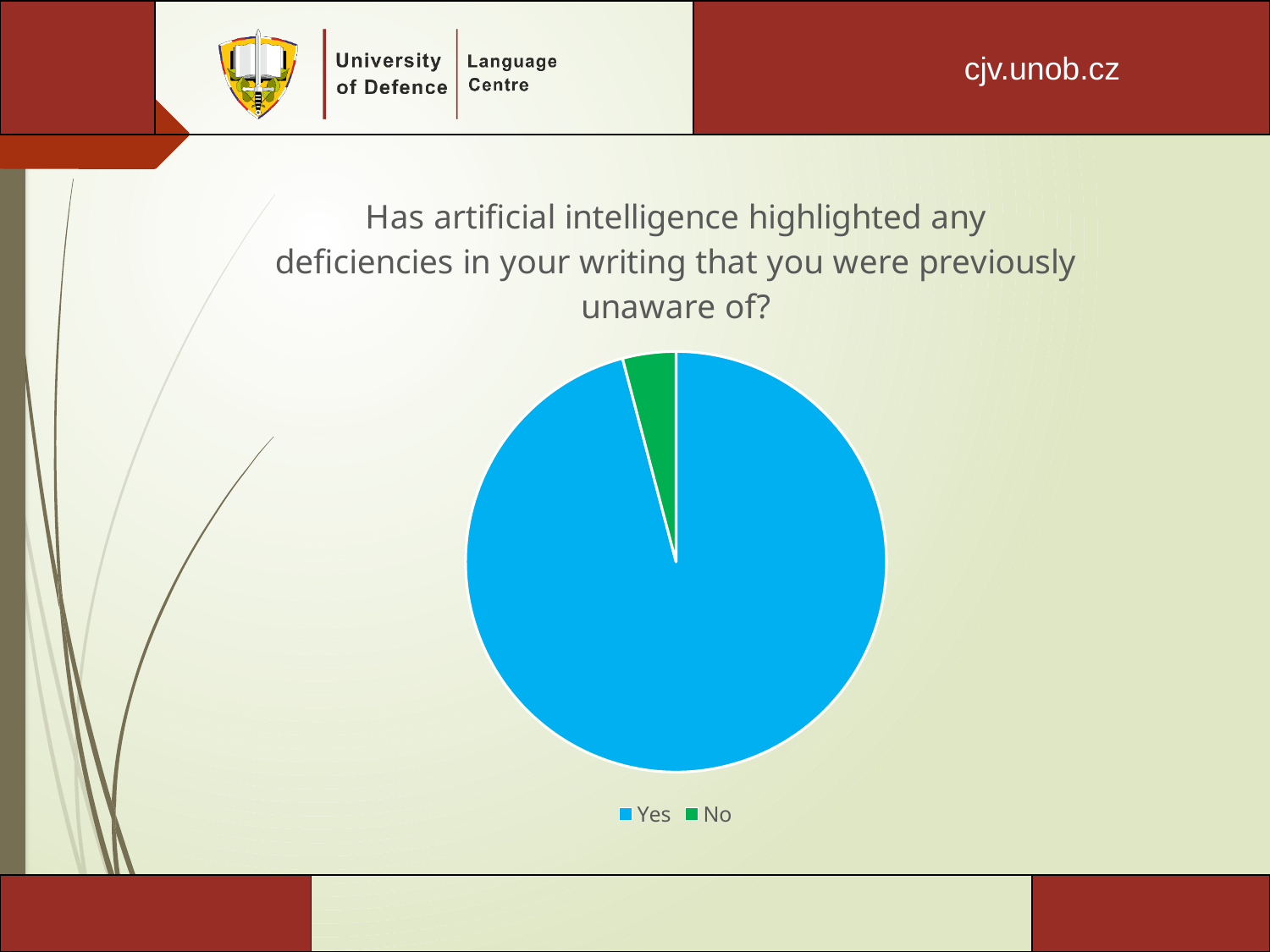
How many categories does the legend of the pie chart list? 2 Which slice is larger in the pie chart, Yes or No? Yes Which category has the largest slice in the pie chart? Yes What colour is the Yes slice in the pie chart? blue How many slices does the pie chart have? 2 What kind of chart is shown on the slide? pie chart What is the title of the pie chart? Has artificial intelligence highlighted any deficiencies in your writing that you were previously unaware of? Which category has the smallest slice in the pie chart? No